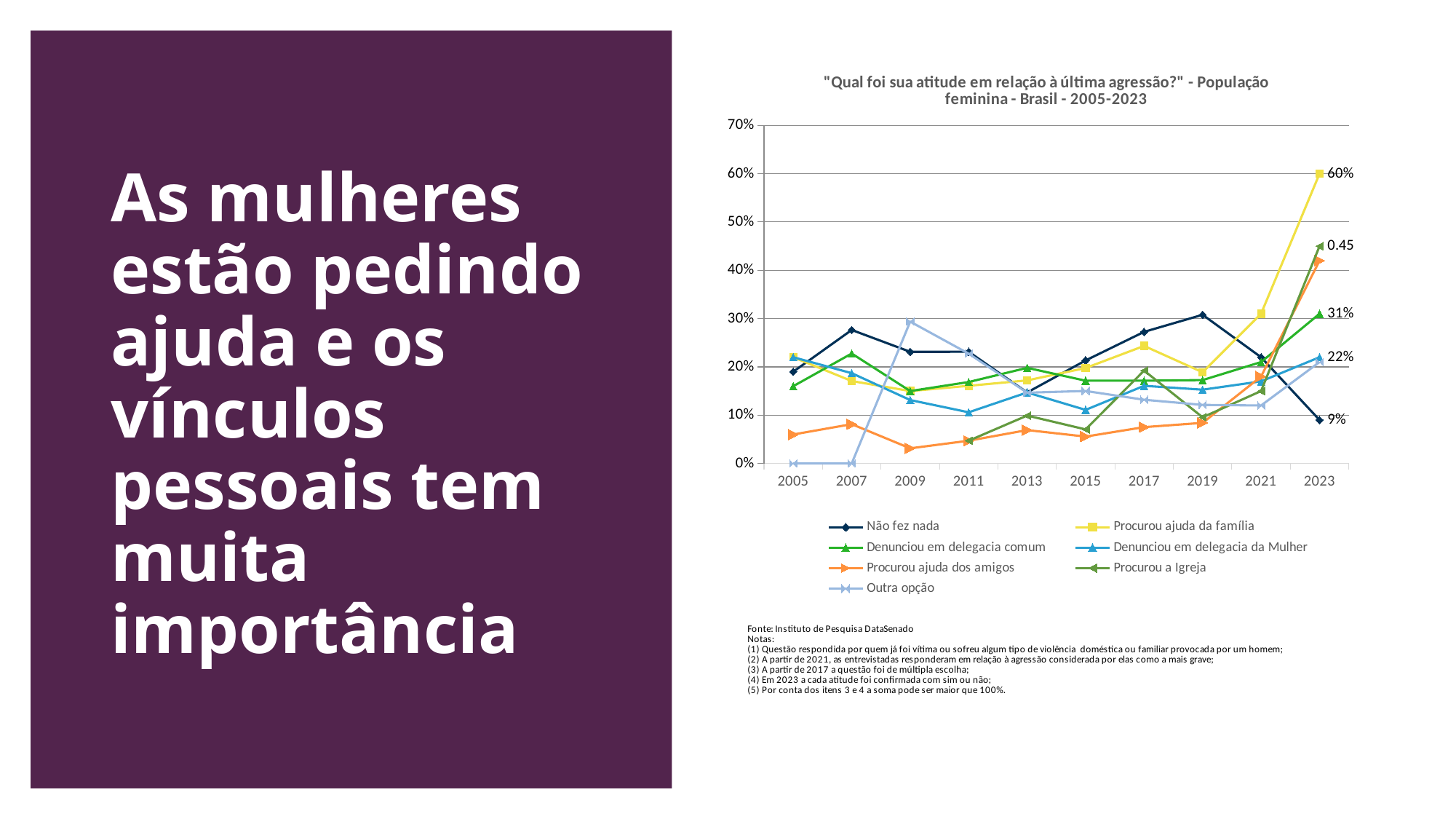
What is the value for "Não fez nada" in 2023? 9% What kind of chart is shown on the slide? line chart What is the data label shown for "Procurou a Igreja" in 2023? 0.45 What is the difference between the 2023 values for "Procurou ajuda da família" and "Denunciou em delegacia comum"? 29% Which series has the highest value in 2023? Procurou ajuda da família How many series does the legend list? 7 Which series has the lowest value in 2023? Não fez nada What is the value for "Denunciou em delegacia comum" in 2023? 31% What is the value for "Procurou ajuda da família" in 2023? 60% How many years are shown on the x axis? 10 What is the value for "Denunciou em delegacia da Mulher" in 2023? 22%